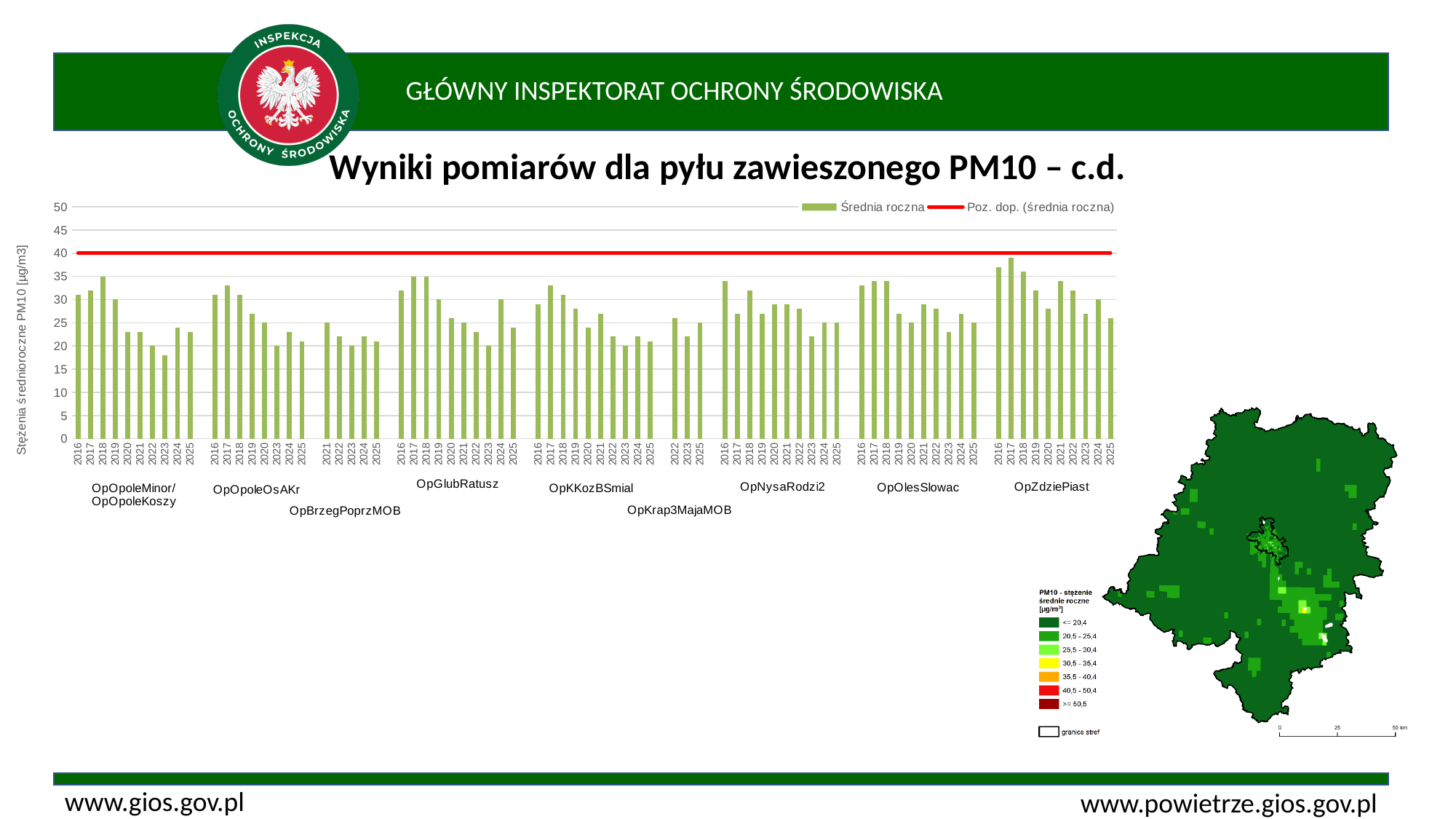
Is the value for OpZdziePiast in 2017 greater or less than 35? greater Which station and year has the highest bar in the chart? OpZdziePiast, 2017 Is the value for OpGlubRatusz in 2017 greater or less than 30? greater Is the value for OpKrap3MajaMOB in 2023 greater or less than 25? less How many years of bars are shown for OpBrzegPoprzMOB? 5 How many series does the chart legend list? 2 At what value on the y axis does the red 'Poz. dop. (średnia roczna)' line sit? 40 What kind of chart is shown on the slide? combination bar and line chart What are the two entries in the chart legend? Średnia roczna; Poz. dop. (średnia roczna) Do any of the bars exceed the red 'Poz. dop.' line at 40? No How many years of bars are shown for OpKrap3MajaMOB? 3